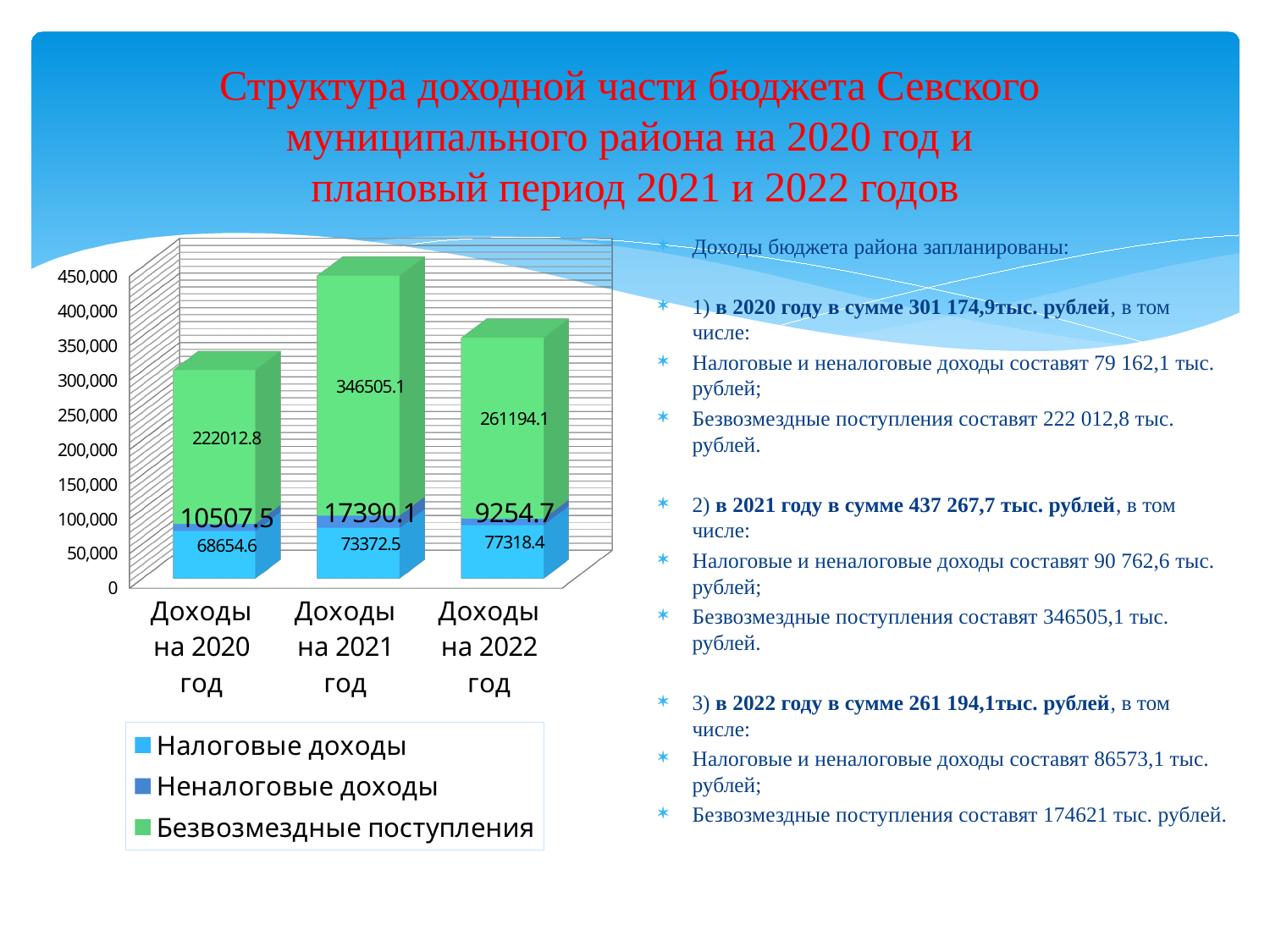
What is the value of Налоговые доходы for Доходы на 2020 год? 68654.6 How many series does the legend list? 3 In which category is the Безвозмездные поступления value the highest? Доходы на 2021 год What kind of chart is shown on the slide? Stacked bar chart How many categories are shown on the x axis? 3 In which category is the Неналоговые доходы value the lowest? Доходы на 2022 год Which is larger: Налоговые доходы for Доходы на 2022 год or for Доходы на 2021 год? Доходы на 2022 год What is the value of Безвозмездные поступления for Доходы на 2021 год? 346505.1 What is the total of the stacked bar for Доходы на 2021 год? 437267.7 What is the value of Неналоговые доходы for Доходы на 2022 год? 9254.7 What is the total of the stacked bar for Доходы на 2020 год? 301174.9 What is the difference between the Безвозмездные поступления values for Доходы на 2021 год and Доходы на 2020 год? 124492.3